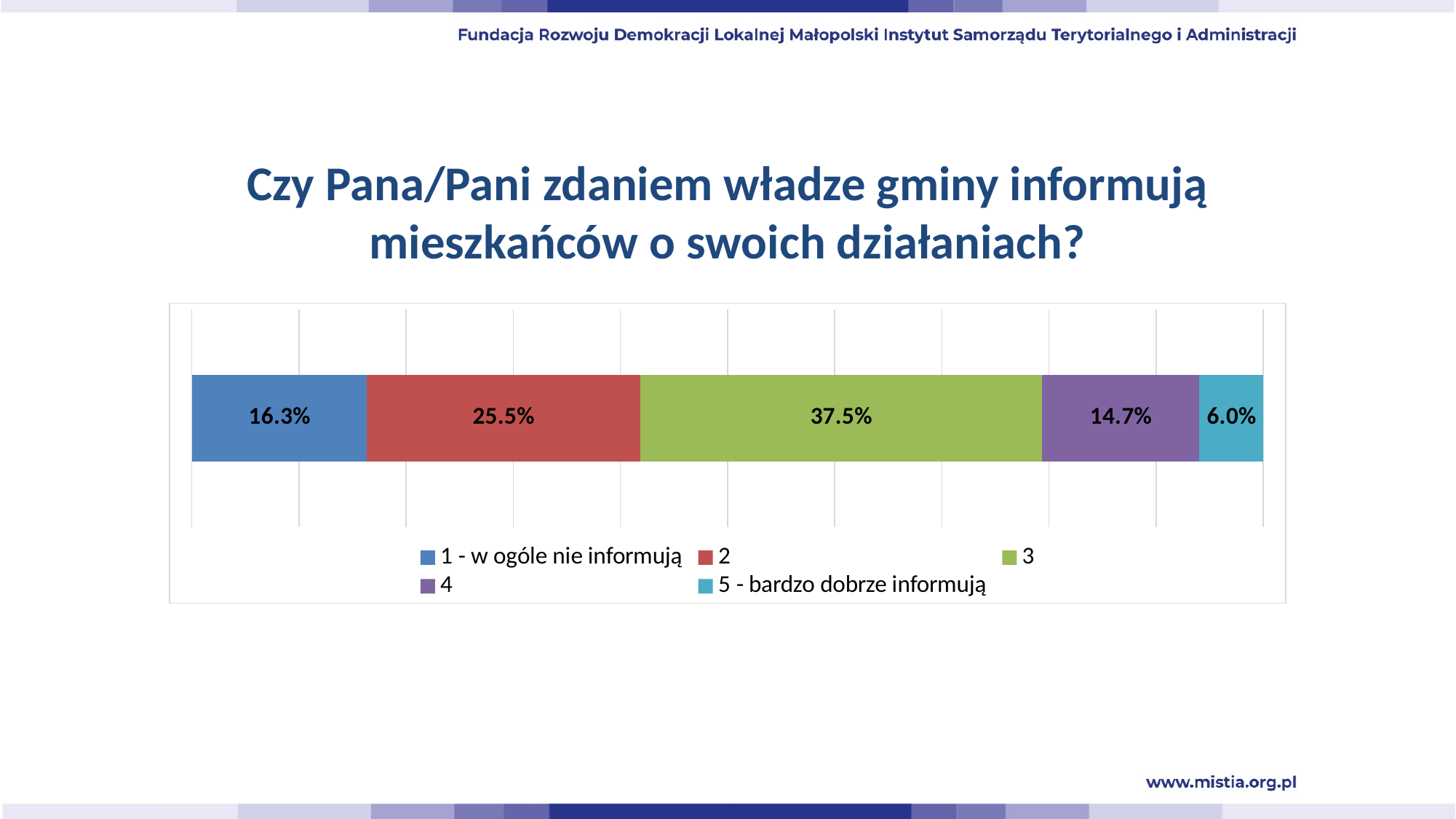
Which response option has the smallest share? 5 - bardzo dobrze informują What colour is the segment for "3"? Green What is the combined share of responses "1 - w ogóle nie informują" and "2"? 41.8% Which is larger: the share for "1 - w ogóle nie informują" or the share for "2"? 2 What is the difference between the share for "2" and the share for "4"? 10.8% How many series does the legend list? 5 What is the value shown for the segment labelled "4"? 14.7% What percentage of respondents chose "5 - bardzo dobrze informują"? 6.0% What kind of chart is shown on the slide? Stacked bar chart What is the value shown for the segment labelled "3"? 37.5% What percentage of respondents chose "1 - w ogóle nie informują"? 16.3% Which response option has the largest share? 3